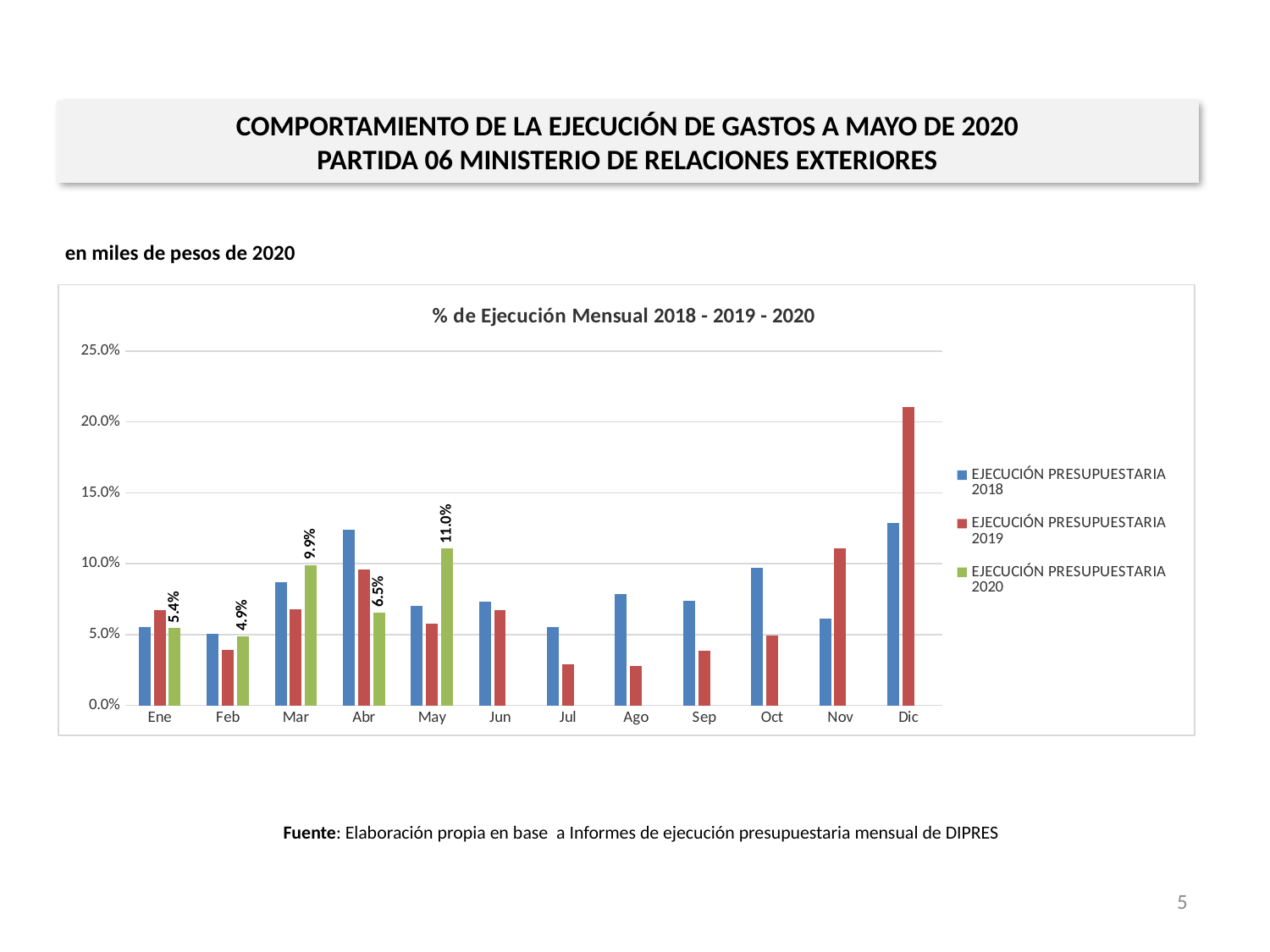
Is the value for EJECUCIÓN PRESUPUESTARIA 2018 in Abr greater or less than 10.0%? greater What is the difference between the EJECUCIÓN PRESUPUESTARIA 2020 values for May and Ene? 5.6% Which month has the highest value for EJECUCIÓN PRESUPUESTARIA 2020? May What is the value for EJECUCIÓN PRESUPUESTARIA 2020 in Mar? 9.9% Which is larger for EJECUCIÓN PRESUPUESTARIA 2020: Mar or Abr? Mar How many series does the legend list? 3 What is the value for EJECUCIÓN PRESUPUESTARIA 2020 in Feb? 4.9% What is the value for EJECUCIÓN PRESUPUESTARIA 2020 in May? 11.0% How many months are shown on the x axis of the chart? 12 Which month has the lowest value for EJECUCIÓN PRESUPUESTARIA 2020? Feb What kind of chart is shown on the slide? bar chart Is the value for EJECUCIÓN PRESUPUESTARIA 2019 in Dic greater or less than 20.0%? greater